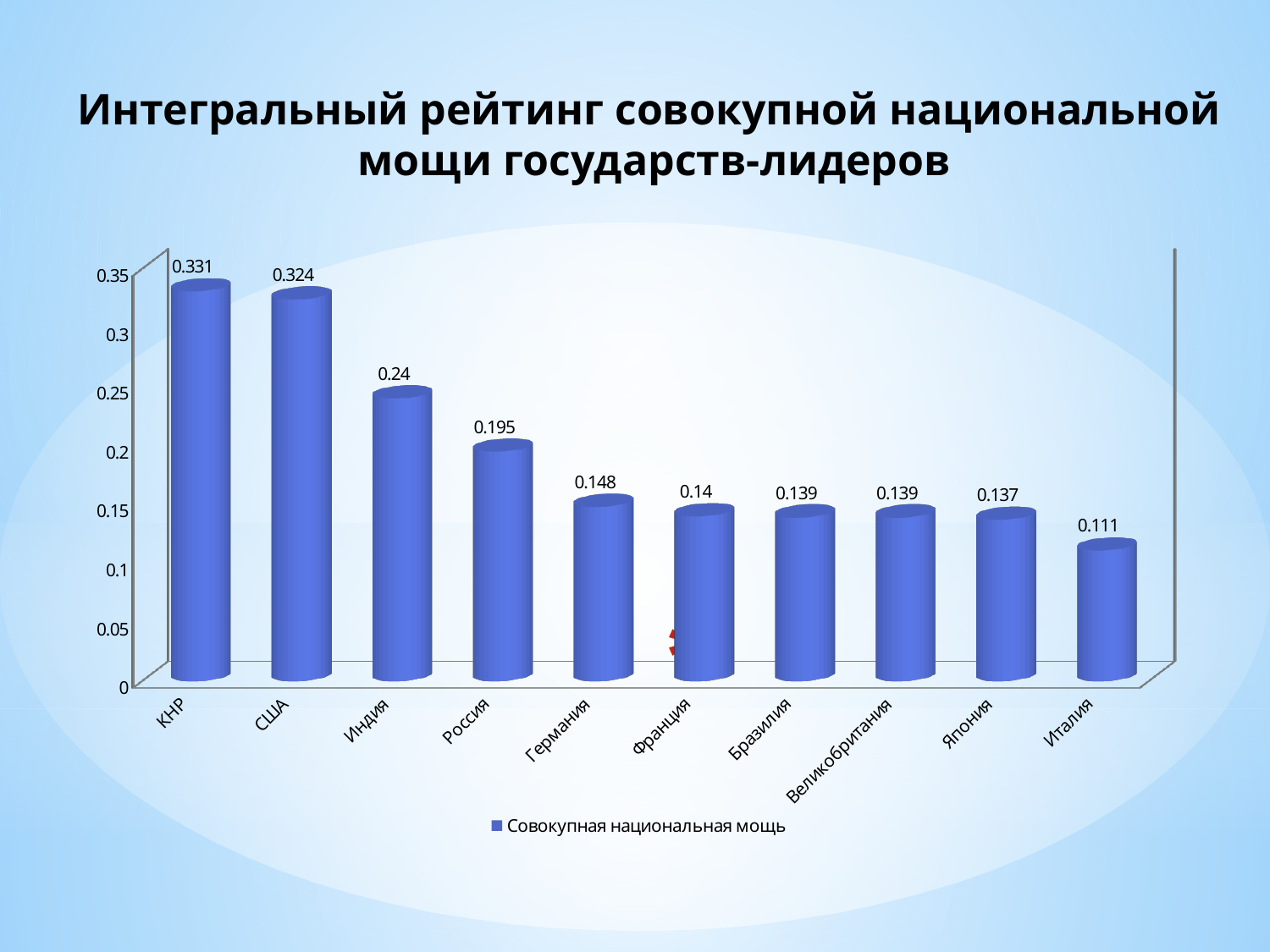
What is the value for Великобритания? 0.139 What is the difference between the values for Индия and Россия? 0.045 What is the legend entry shown below the chart? Совокупная национальная мощь Which country has the highest value? КНР How many countries are shown on the chart? 10 What is the value for КНР? 0.331 What is the difference between the values for КНР and США? 0.007 Which country has the lowest value? Италия What is the value for Италия? 0.111 Which is larger, the value for Индия or the value for Германия? Индия What is the value for Россия? 0.195 What kind of chart is shown on the slide? Bar chart